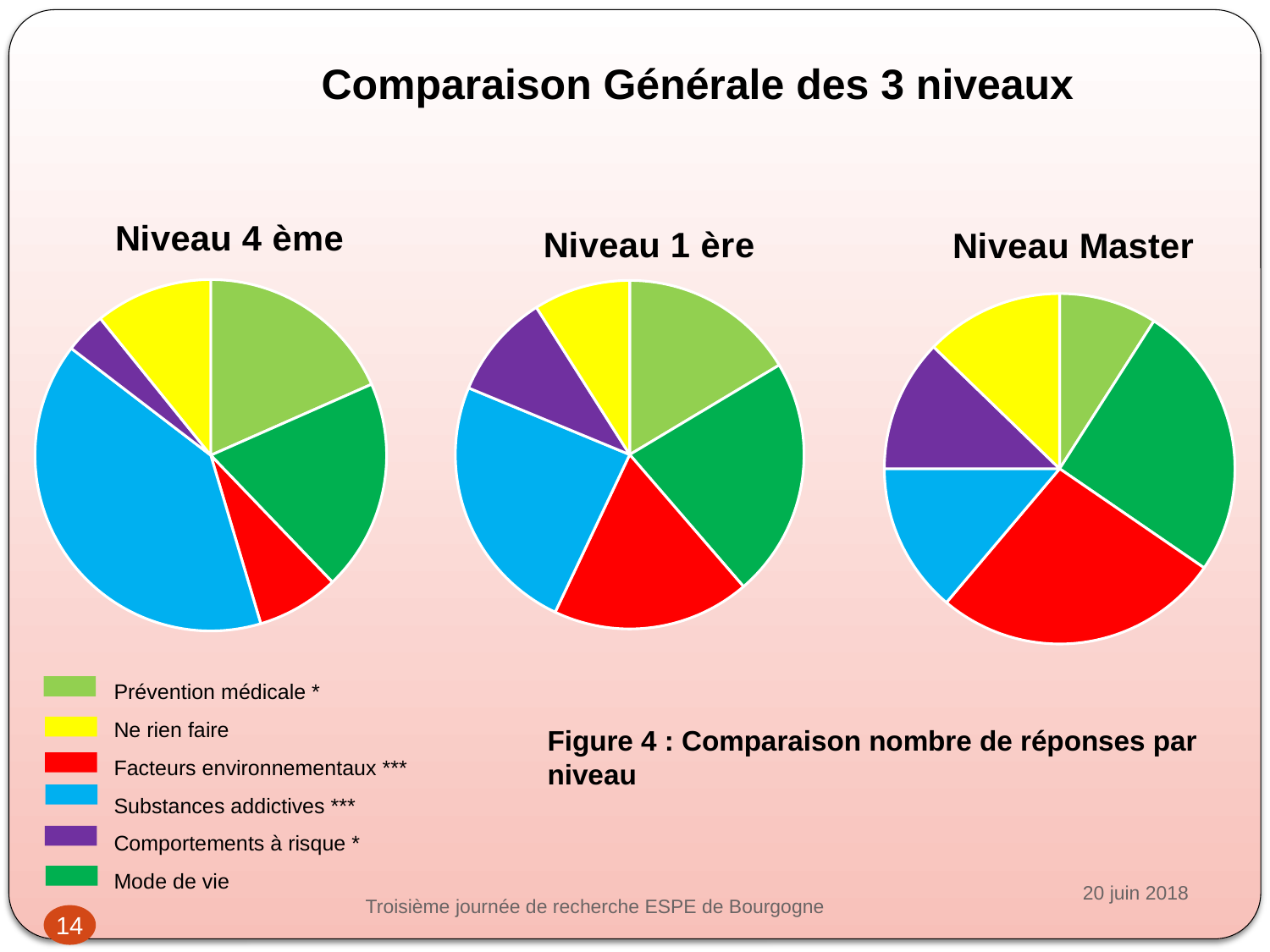
How many pie charts are shown on the slide? 3 What is the title of the pie chart on the right of the slide? Niveau Master In the Niveau Master pie chart, which category has the smallest slice? Prévention médicale * How many categories does the legend list? 6 In the Niveau 4 ème pie chart, which category has the largest slice? Substances addictives *** What kind of chart is used for the Niveau 4 ème data? pie chart In the Niveau 4 ème pie chart, which category has the smallest slice? Comportements à risque * In the Niveau Master pie chart, which slice is larger: Prévention médicale * or Facteurs environnementaux ***? Facteurs environnementaux *** In the Niveau 4 ème pie chart, which slice is larger: Ne rien faire or Comportements à risque *? Ne rien faire Which colour represents Mode de vie in the legend? green How many slices does the Niveau 1 ère pie chart have? 6 In the Niveau 4 ème pie chart, which slice is larger: Substances addictives *** or Facteurs environnementaux ***? Substances addictives ***